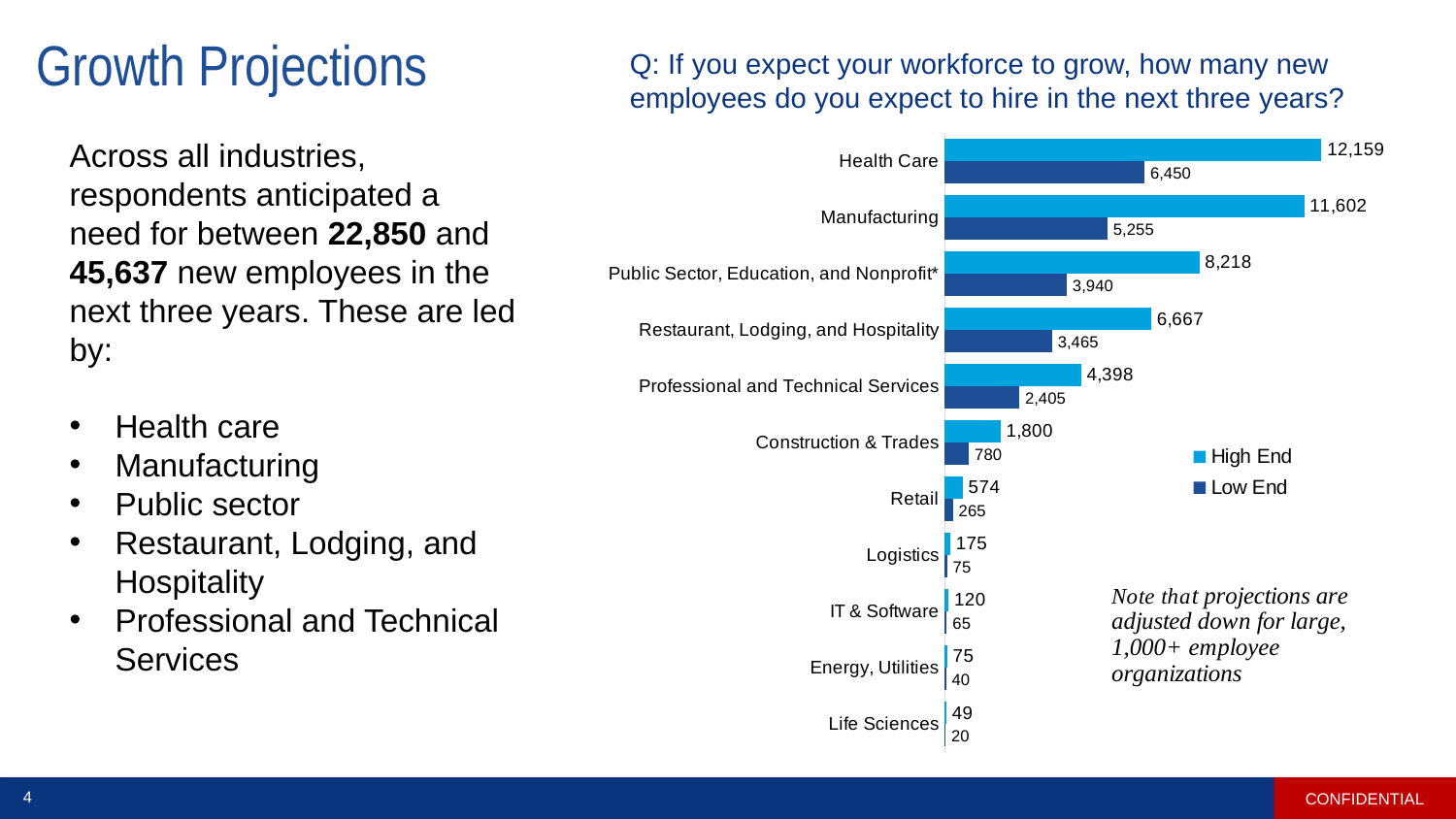
Which industry has the highest High End value? Health Care What is the Low End value for Manufacturing? 5,255 What is the difference between the High End values for Health Care and Manufacturing? 557 Which industry has the lowest Low End value? Life Sciences What is the difference between the High End and Low End values for Public Sector, Education, and Nonprofit*? 4,278 How many industries are shown in the chart? 11 What is the Low End value for Restaurant, Lodging, and Hospitality? 3,465 Which is larger: the High End value for Construction & Trades or the High End value for Retail? Construction & Trades What is the High End value for Health Care? 12,159 How many series does the legend list? 2 What kind of chart is shown on the slide? Bar chart Which legend entry is shown in the darker blue colour? Low End